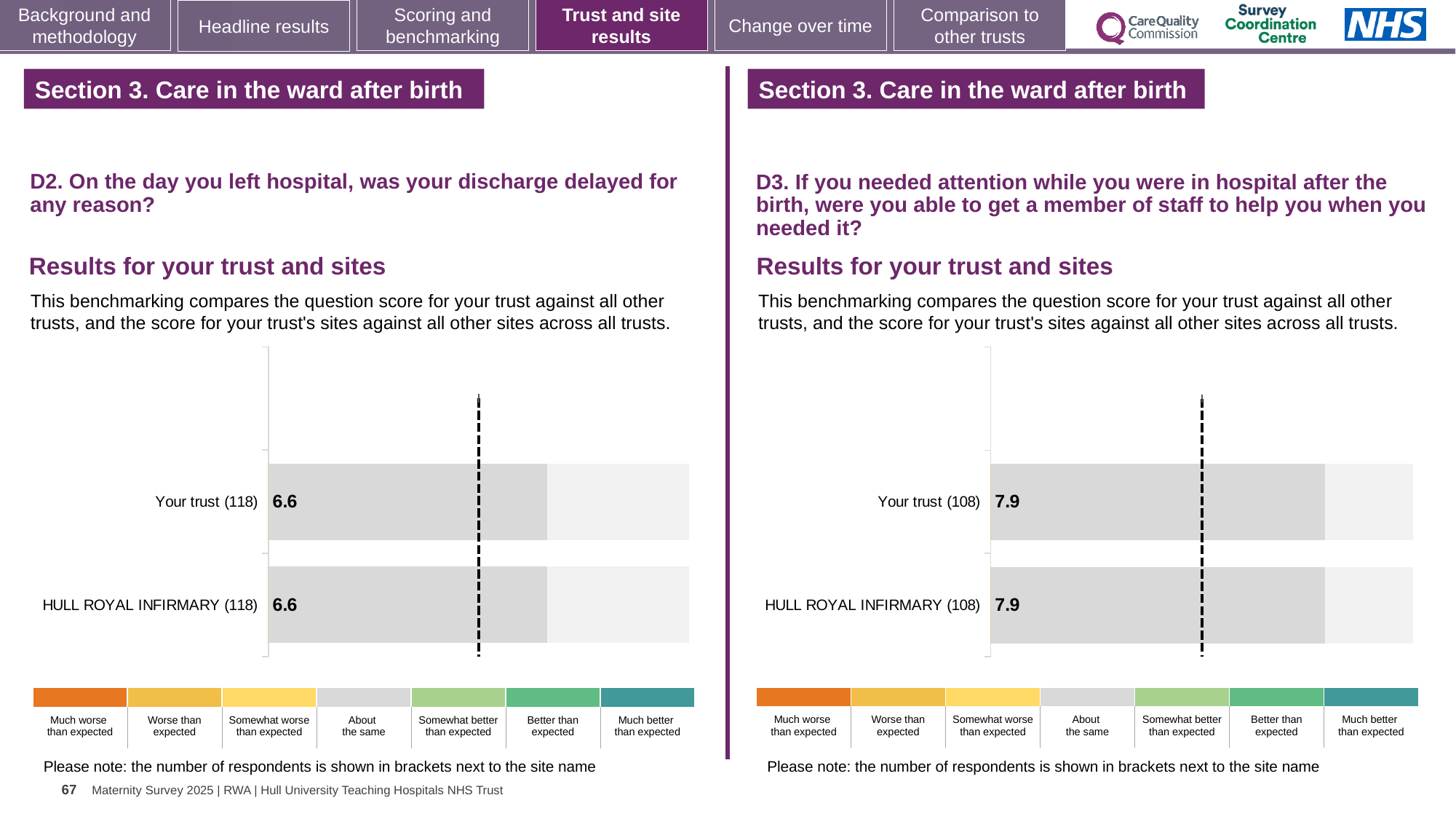
What is the difference between the Your trust score in the right chart (D3) and the Your trust score in the left chart (D2)? 1.3 In the left chart (D2, discharge delayed), what is the score for Your trust? 6.6 Which is larger: the Your trust score in the left chart (D2) or the Your trust score in the right chart (D3)? The right chart (D3), 7.9 In the right chart (D3, able to get a member of staff to help), what is the score for Your trust? 7.9 In the left chart (D2, discharge delayed), what is the score for HULL ROYAL INFIRMARY? 6.6 In the left chart (D2), how many respondents are shown in brackets next to Your trust? 118 How many bars are plotted in the right chart (D3)? 2 In the right chart (D3, able to get a member of staff to help), what is the score for HULL ROYAL INFIRMARY? 7.9 What kind of chart is used on the left side of the slide for question D2? Bar chart In the left chart (D2), is the score for Your trust the same as the score for HULL ROYAL INFIRMARY? Yes, both are 6.6 In the right chart (D3), how many respondents are shown in brackets next to HULL ROYAL INFIRMARY? 108 How many bars are plotted in the left chart (D2)? 2